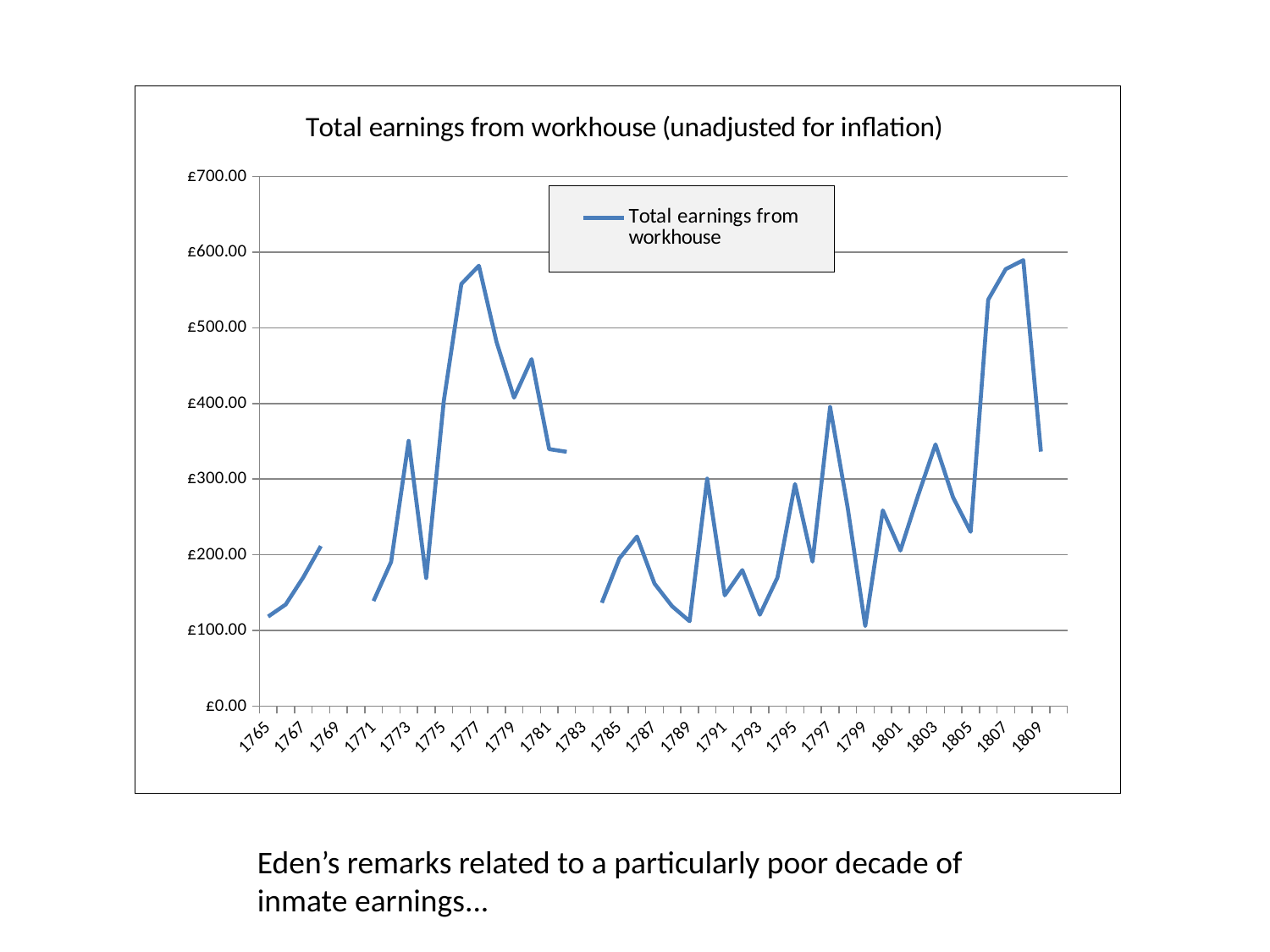
Is the value for 1808 greater or less than £500.00? greater What kind of chart is shown on the slide? line chart Do the values rise or fall from 1777 to 1781? fall Is the value for 1797 greater or less than £300.00? greater Which year has the larger value, 1797 or 1799? 1797 Is the value for 1765 greater or less than £200.00? less What is the highest value shown on the y axis? £700.00 What is the title of the chart? Total earnings from workhouse (unadjusted for inflation) How many series does the legend list? 1 Which year has the larger value, 1777 or 1765? 1777